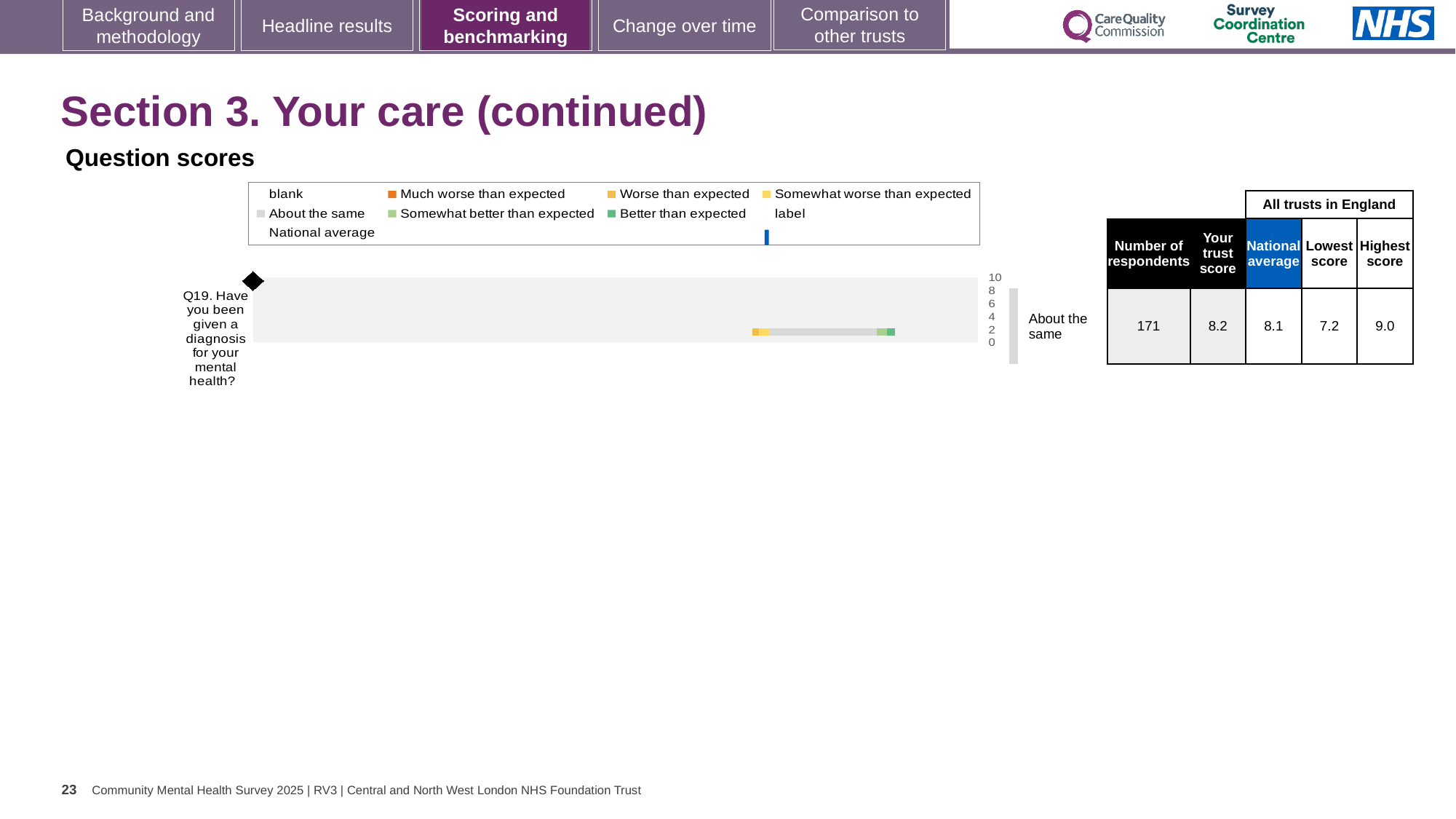
What is the lowest score among all trusts in England for Q19? 7.2 Is the trust score for Q19 higher or lower than the national average? higher What kind of chart is shown on the slide? bar chart What is the difference between the highest and lowest scores for Q19 across all trusts in England? 1.8 What is the trust score for Q19? 8.2 What is the difference between the trust score and the national average for Q19? 0.1 What is the national average score for Q19? 8.1 How many respondents answered Q19? 171 Which question is plotted on the chart? Q19. Have you been given a diagnosis for your mental health? How many questions are plotted on the chart? 1 What is the highest score among all trusts in England for Q19? 9.0 What benchmark category is the trust's Q19 score placed in? About the same